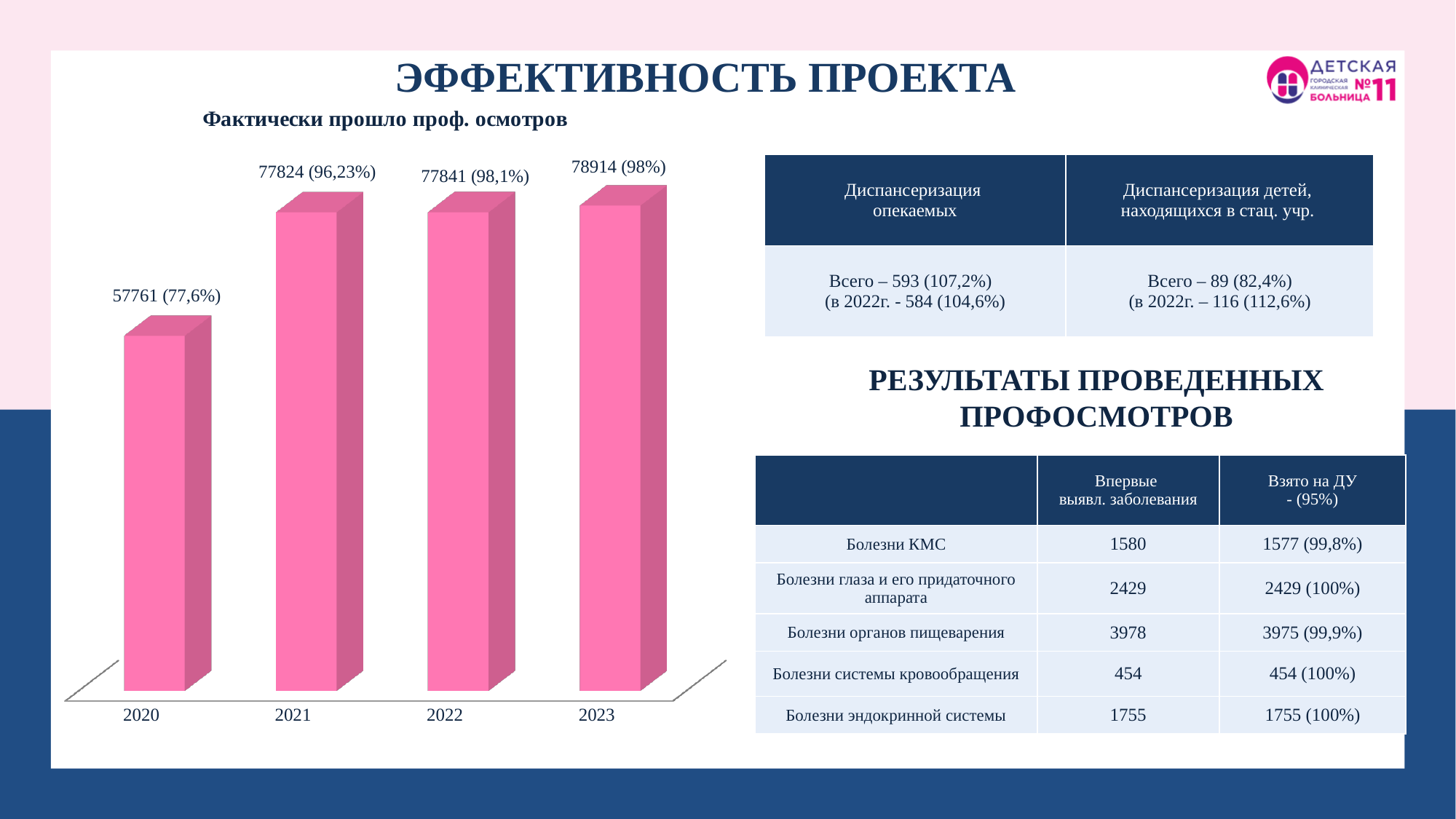
Which year has the lowest bar in the chart? 2020 How many years are shown on the x axis of the bar chart? 4 Which year has the highest bar in the chart? 2023 What is the difference between the number of examinations in 2022 and in 2021? 17 What value is shown for 2021 in the bar chart? 77824 (96,23%) What kind of chart is shown on the slide? Bar chart Do the values in the chart rise or fall from 2020 to 2023? Rise What value is shown for 2020 in the bar chart? 57761 (77,6%) Which year has the larger value, 2020 or 2021? 2021 What value is shown for 2023 in the bar chart? 78914 (98%) What is the difference between the number of examinations in 2023 and in 2020? 21153 What value is shown for 2022 in the bar chart? 77841 (98,1%)